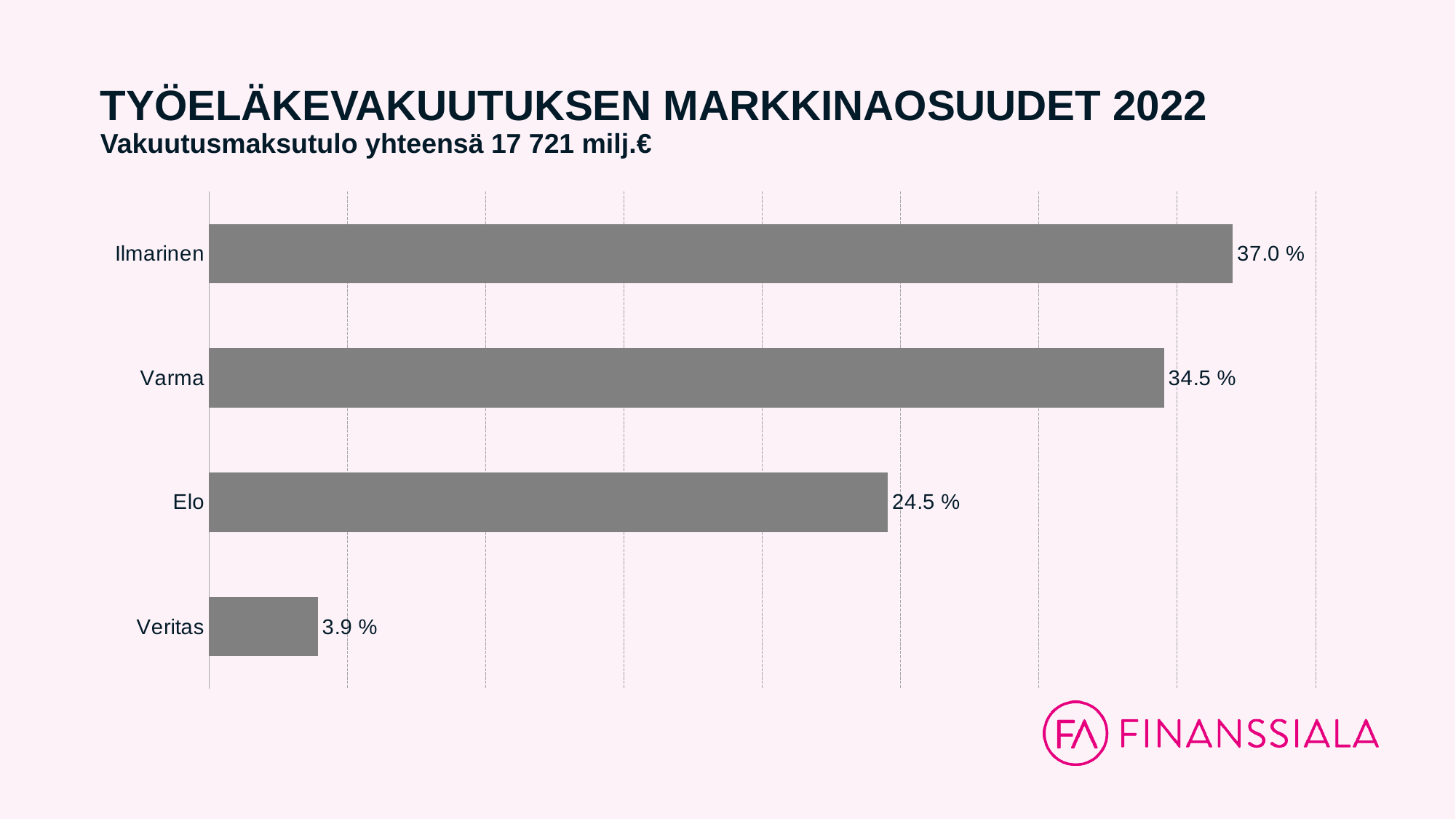
What is the difference in market share between Elo and Veritas? 20.6 % Which has a larger market share, Varma or Elo? Varma What total premium income (vakuutusmaksutulo yhteensä) is stated in the subtitle? 17 721 milj.€ What is the market share shown for Ilmarinen? 37.0 % What is the market share shown for Varma? 34.5 % What is the market share shown for Veritas? 3.9 % What is the market share shown for Elo? 24.5 % What is the difference in market share between Ilmarinen and Varma? 2.5 % What kind of chart is shown on the slide? Bar chart How many companies are shown in the chart? 4 Which company has the lowest market share? Veritas Which company has the highest market share? Ilmarinen